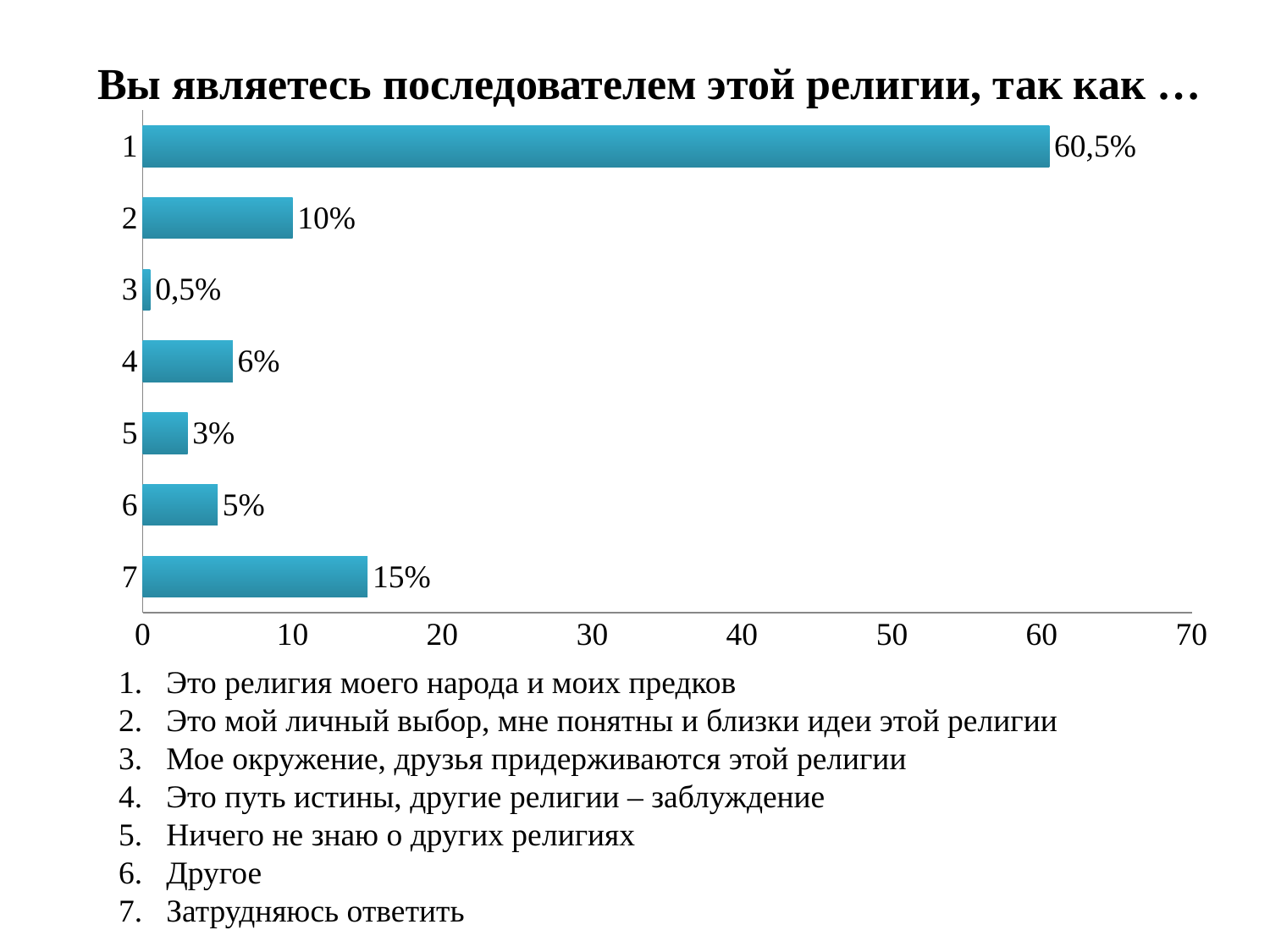
Is the value for category 1 greater or less than 50? greater What is the value for category 7? 15% How many categories are shown in the chart? 7 Which category has the highest value? 1 What kind of chart is shown on the slide? bar chart What is the title of the chart? Вы являетесь последователем этой религии, так как … Which is larger, the value for category 4 or category 6? 4 What is the difference between the values for category 2 and category 7? 5% What is the maximum value shown on the horizontal axis? 70 What is the value for category 1? 60,5% Which category has the lowest value? 3 What is the value for category 3? 0,5%